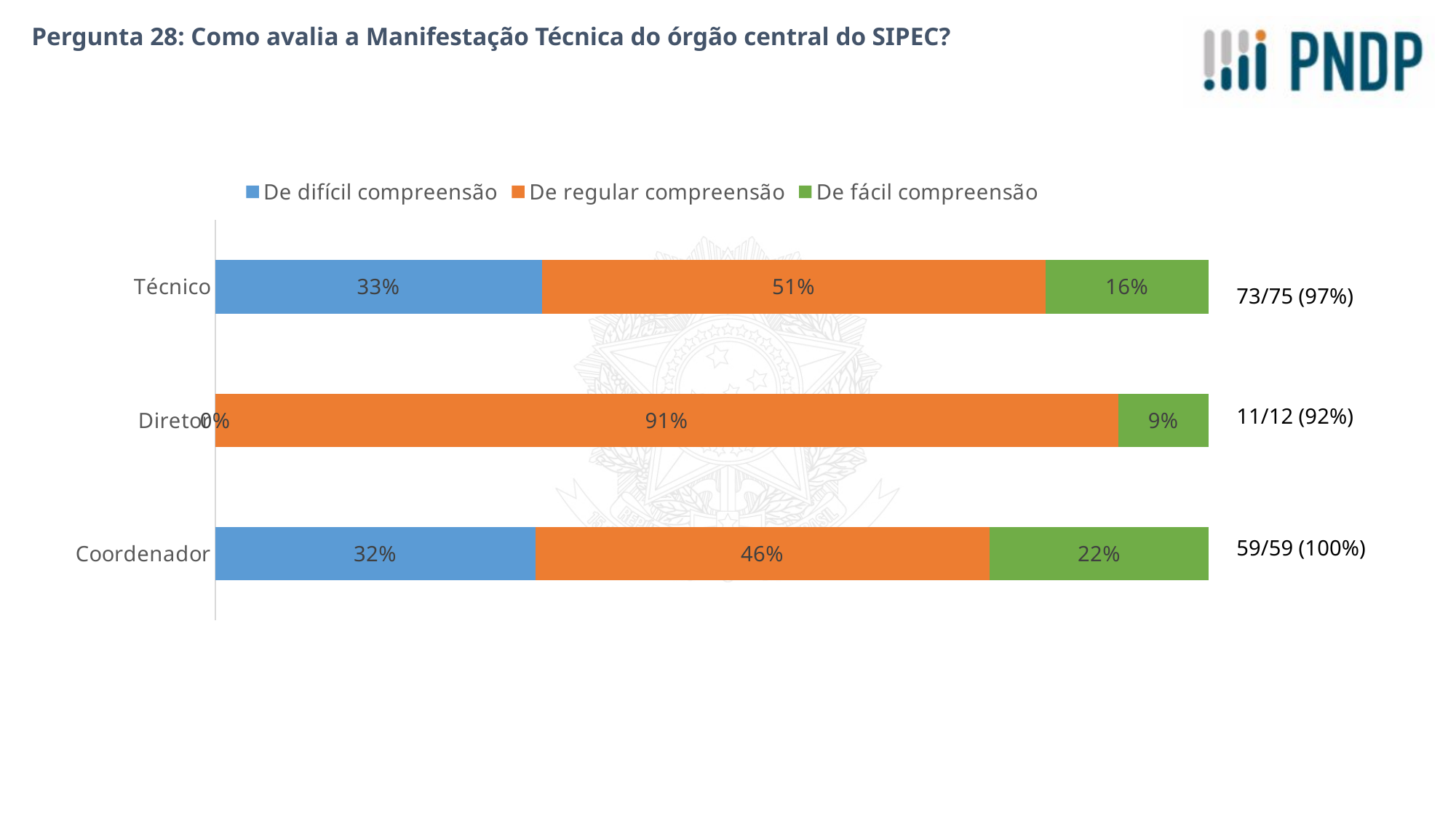
What response count and rate is shown next to the Coordenador bar? 59/59 (100%) What percentage of Diretor respondents rated it 'De fácil compreensão'? 9% Which is larger: the 'De regular compreensão' value for Técnico or for Coordenador? Técnico What kind of chart is shown on the slide? Stacked bar chart Which category has the highest 'De regular compreensão' percentage? Diretor What percentage of Técnico respondents rated the Manifestação Técnica as 'De regular compreensão'? 51% How many categories are shown on the y axis of the chart? 3 What is the difference between the 'De fácil compreensão' percentages for Coordenador and Técnico? 6% Which category has the lowest 'De fácil compreensão' percentage? Diretor What percentage of Coordenador respondents rated it 'De difícil compreensão'? 32% What is the 'De difícil compreensão' value for Diretor? 0% How many series does the legend list? 3